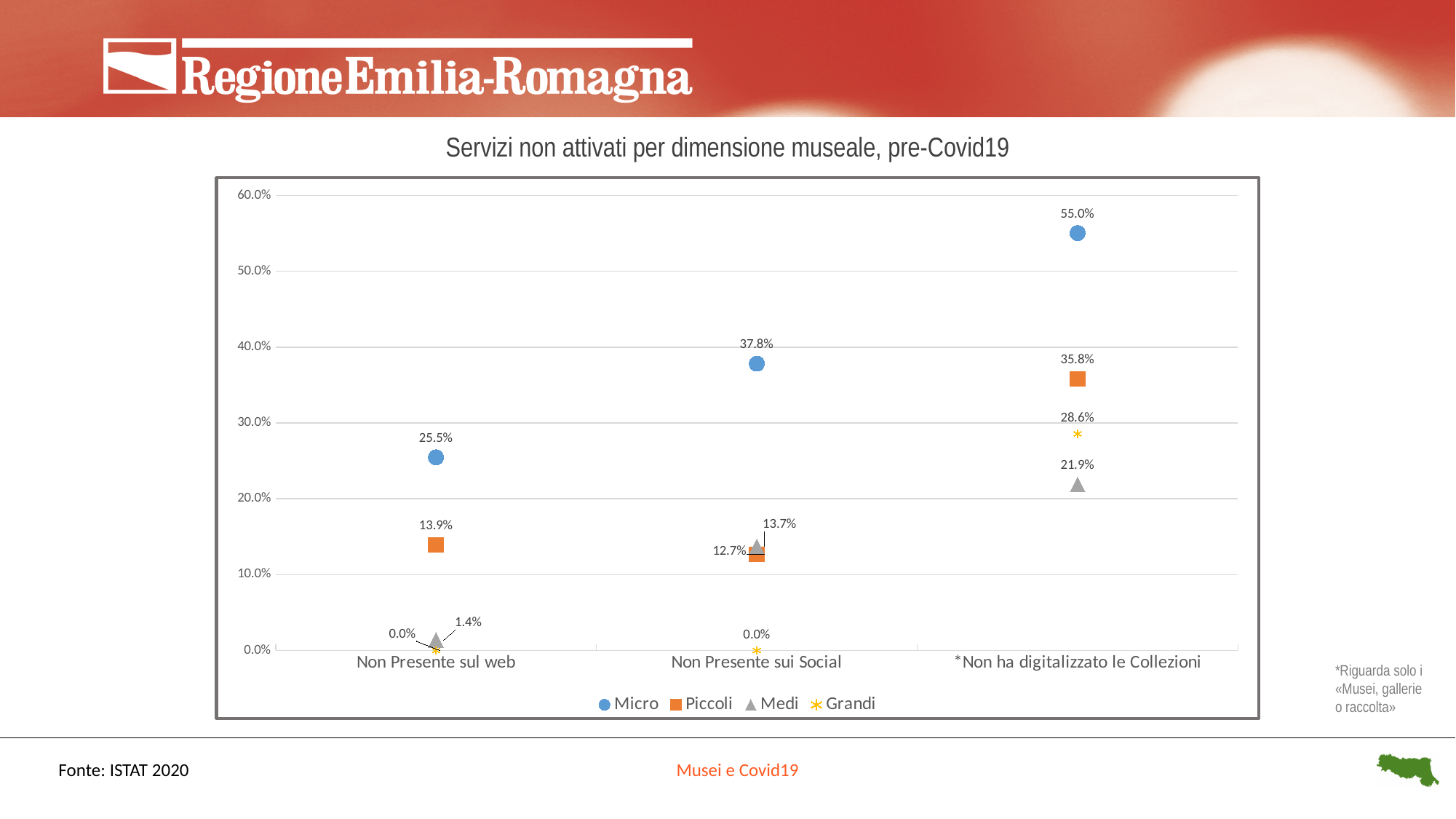
Which category has the highest value for the Micro series? Non ha digitalizzato le Collezioni What is the difference between the Micro and Piccoli values in the 'Non ha digitalizzato le Collezioni' category? 19.2% What is the value for Grandi in the 'Non ha digitalizzato le Collezioni' category? 28.6% What is the title of the chart? Servizi non attivati per dimensione museale, pre-Covid19 Which series has the lowest value in the 'Non ha digitalizzato le Collezioni' category? Medi Which is larger in the 'Non Presente sui Social' category: Piccoli or Medi? Medi What is the value for Medi in the 'Non Presente sui Social' category? 13.7% What is the value for Piccoli in the 'Non Presente sul web' category? 13.9% What is the value for Micro in the 'Non ha digitalizzato le Collezioni' category? 55.0% How many categories are shown on the x axis? 3 Is the value for Micro in 'Non Presente sui Social' greater or less than 30.0%? greater How many series does the legend list? 4